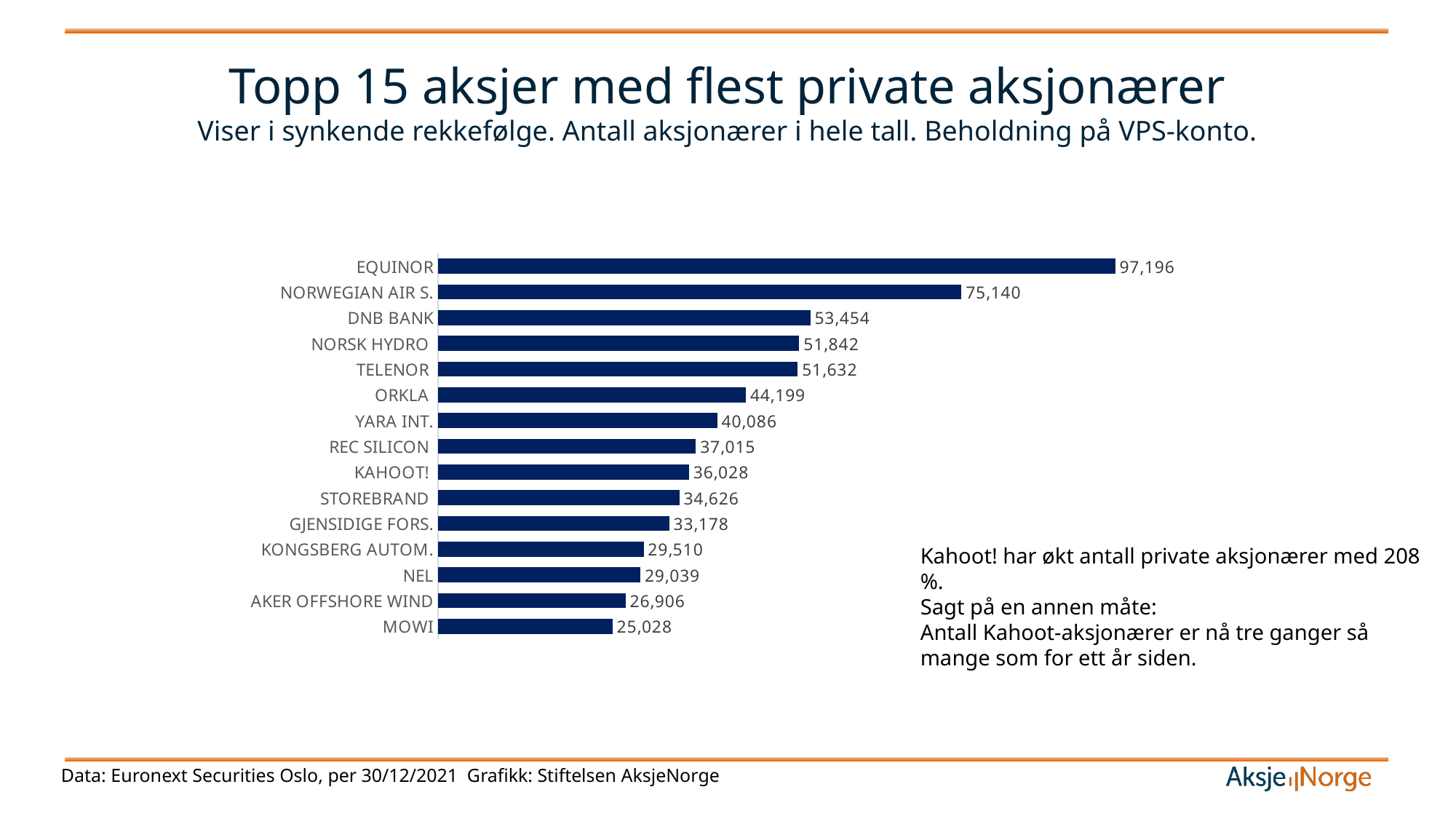
What type of chart is shown on the slide? Bar chart Which company has the highest number of private shareholders? Equinor What is the value shown for Mowi? 25,028 Which company has the lowest number of private shareholders on the chart? Mowi What is the value shown for Aker Offshore Wind? 26,906 What is the difference between the values for Equinor and Norwegian Air S.? 22,056 How many companies are shown in the chart? 15 How many private shareholders does Equinor have according to the chart? 97,196 What is the value shown for Kahoot!? 36,028 What is the difference between the values for DNB Bank and Norsk Hydro? 1,612 Which has more private shareholders, Nel or Kongsberg Autom.? Kongsberg Autom. Which has more private shareholders, Orkla or Yara Int.? Orkla